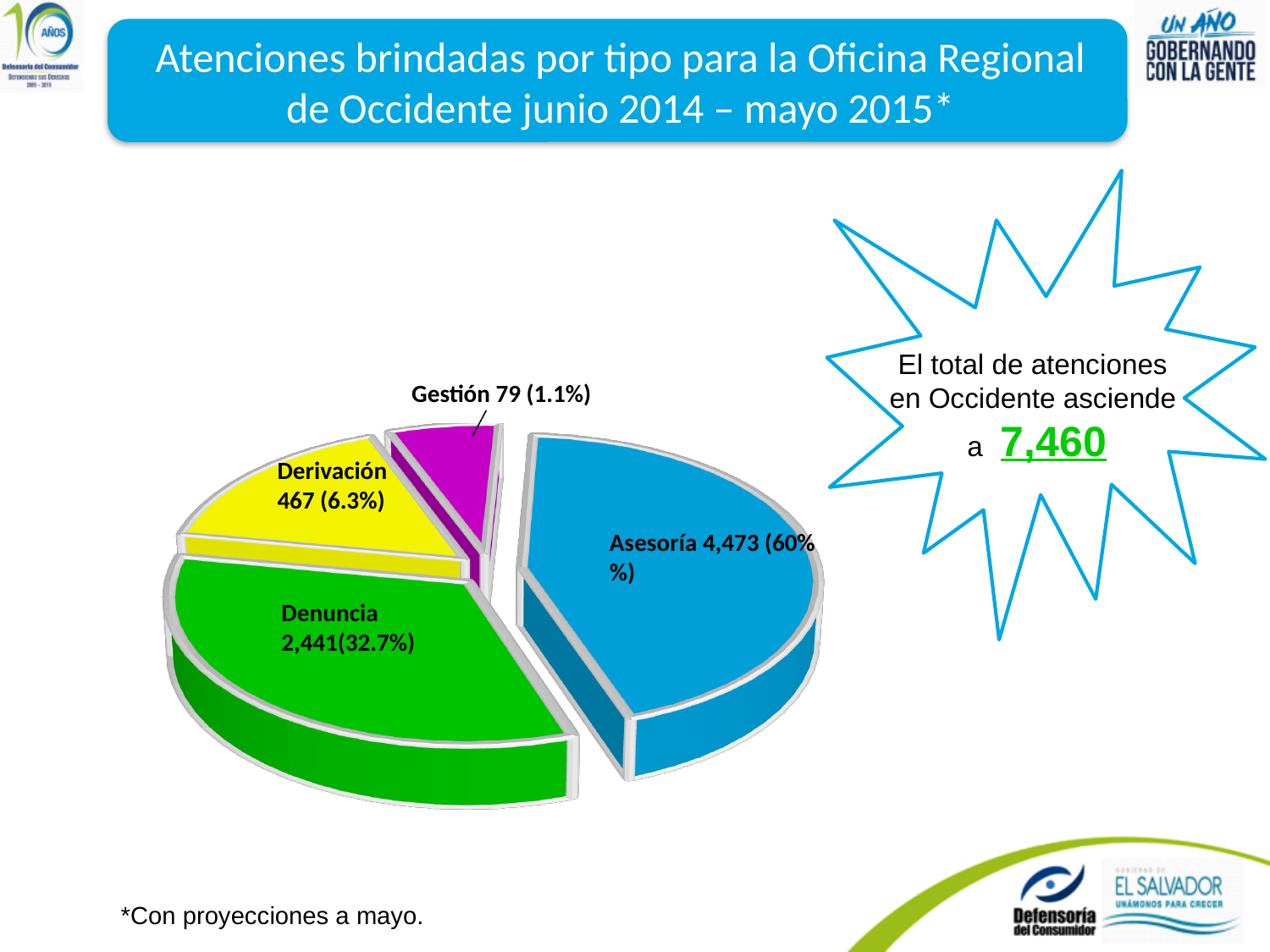
What is the difference between the values for Asesoría and Denuncia? 2,032 How many slices does the pie chart have? 4 What is the value for Asesoría in the pie chart? 4,473 Which category has the largest slice of the pie chart? Asesoría What share of the pie does Derivación represent? 6.3% Which category has the smallest slice of the pie chart? Gestión What kind of chart is shown on the slide? pie chart What is the value for Derivación in the pie chart? 467 What share of the pie does Denuncia represent? 32.7% Which is larger, the value for Derivación or the value for Gestión? Derivación What is the value for Denuncia in the pie chart? 2,441 What is the value for Gestión in the pie chart? 79